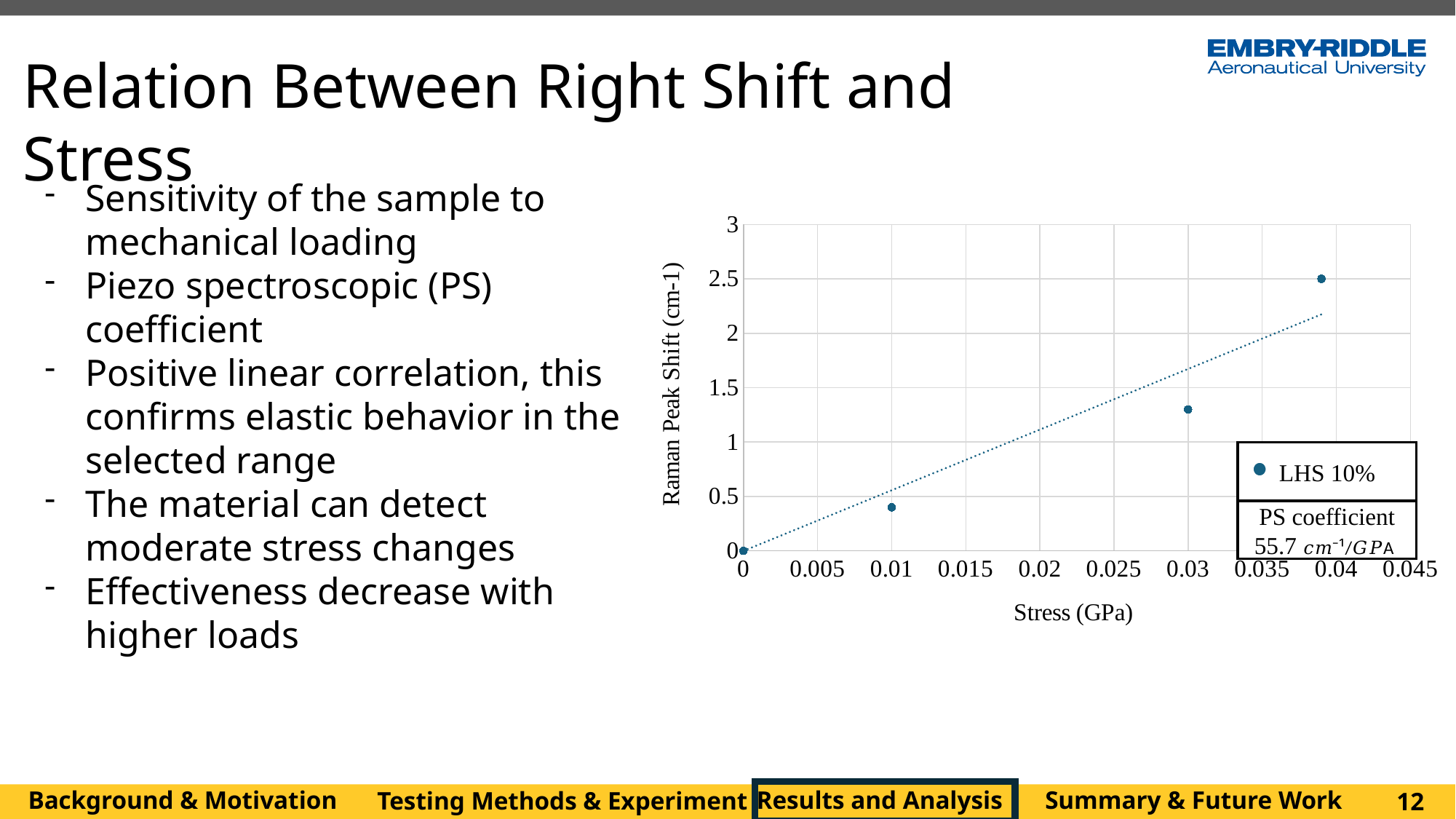
Does the Raman peak shift rise or fall as stress increases along the x axis? rise Which plotted point has the lowest Raman peak shift? the point at 0 GPa Is the highest plotted Raman peak shift greater or less than 2? greater What is the label of the chart's x axis? Stress (GPa) Which has the larger Raman peak shift: the point at 0.01 GPa or the point at 0.03 GPa? 0.03 GPa Is the Raman peak shift at a stress of 0.03 GPa greater or less than 1? greater Is the Raman peak shift at a stress of 0.01 GPa greater or less than 0.5? less What is the name of the series shown in the chart legend? LHS 10% How many data points are plotted in the chart? 4 How many series does the chart legend list? 1 What is the Raman peak shift at a stress of 0 GPa? 0 What kind of chart is shown on the slide? scatter chart